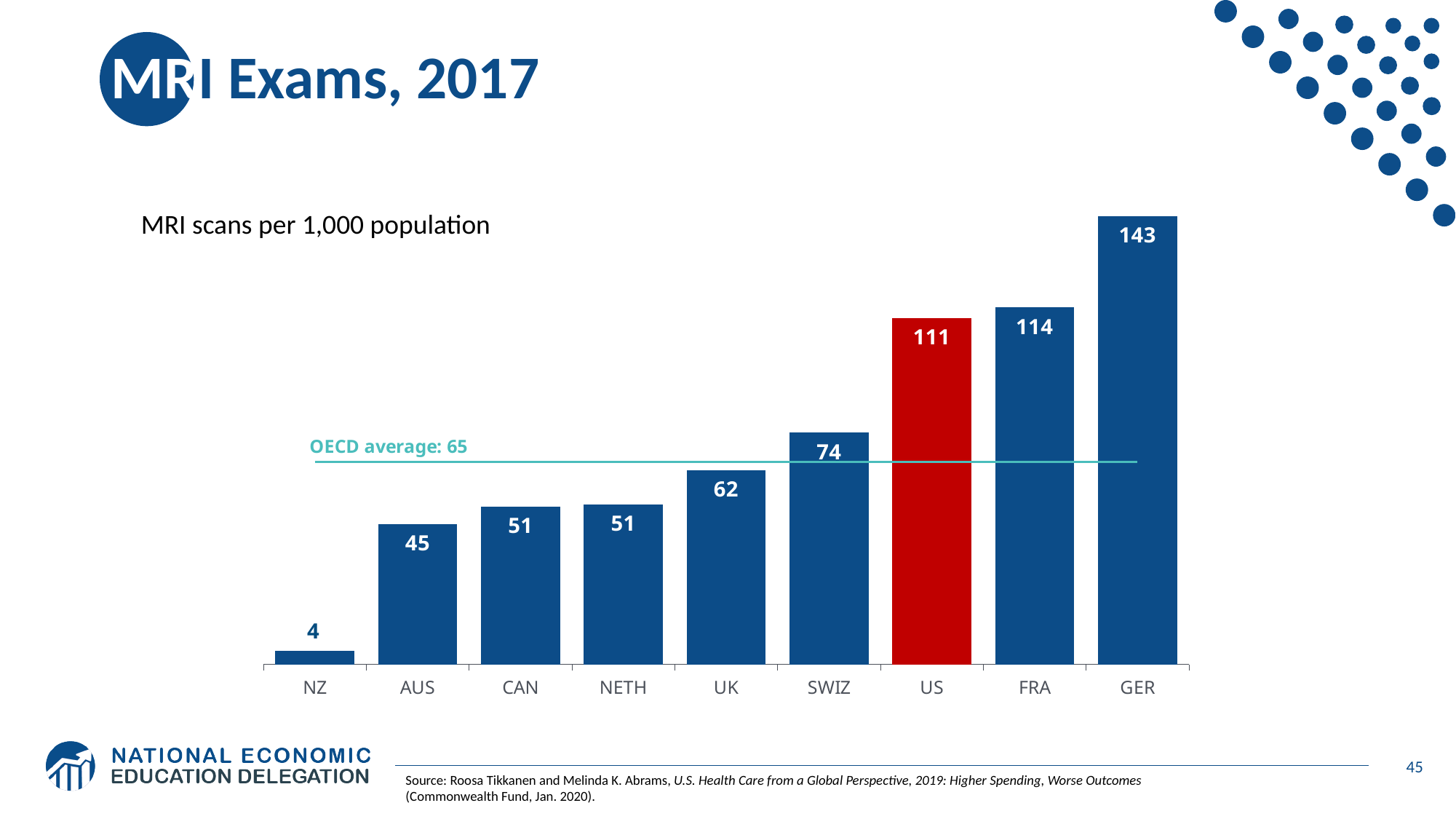
What kind of chart is shown on the slide? Bar chart Which is larger, the value for UK or the value for AUS? UK Do the values rise or fall from left to right across the chart? Rise What OECD average value is marked by the horizontal line on the chart? 65 What is the value for NZ? 4 What is the difference between the values for FRA and SWIZ? 40 Which country has the highest number of MRI scans per 1,000 population? GER How many countries are shown on the chart? 9 What is the value for GER? 143 What is the value for the US? 111 What is the difference between the values for GER and the US? 32 Which country has the lowest number of MRI scans per 1,000 population? NZ